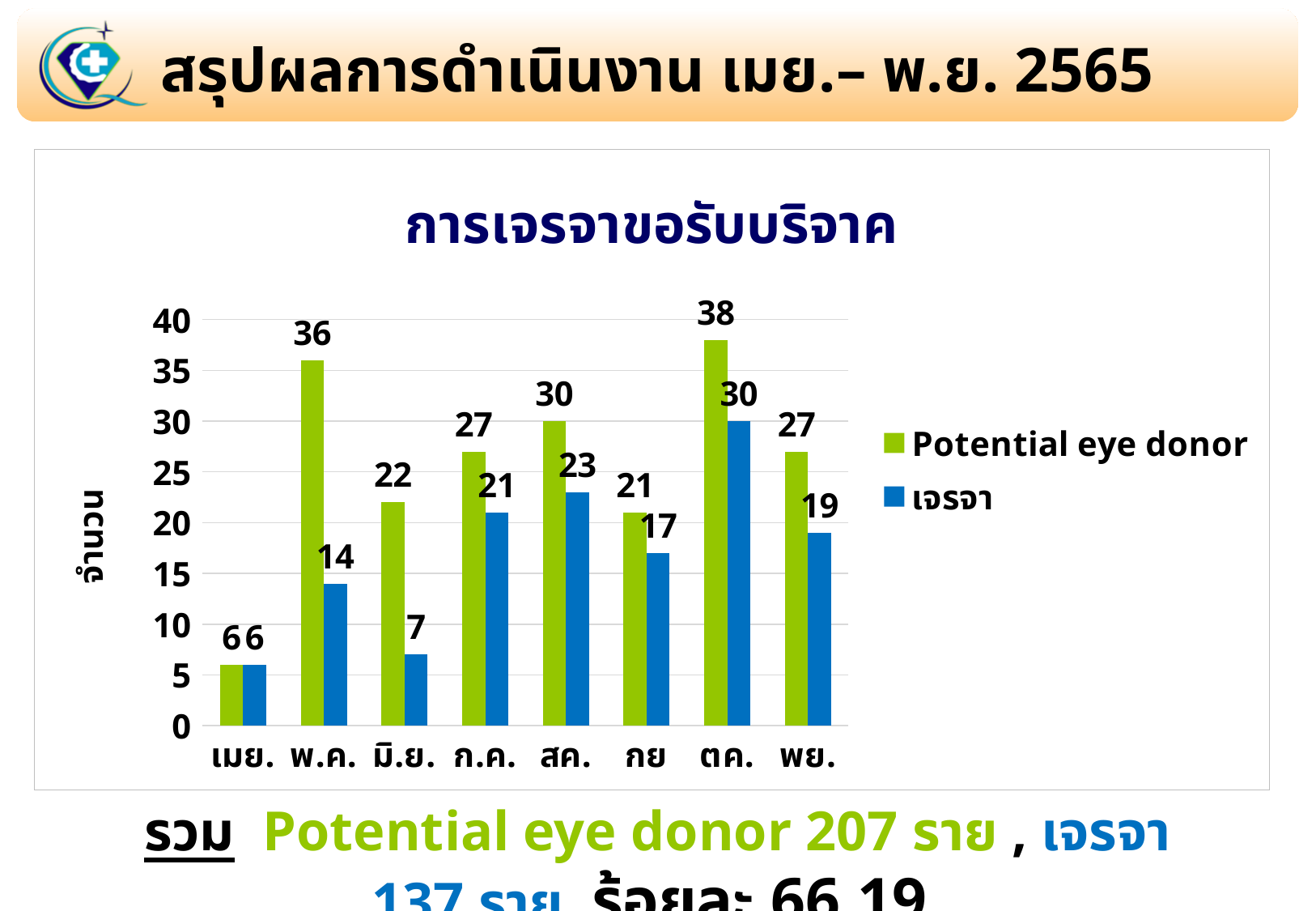
How many months are shown on the x axis? 8 What is the value for เจรจา in ก.ค.? 21 What is the value for Potential eye donor in ตค.? 38 Which is larger, the เจรจา value in สค. or the เจรจา value in กย? สค. What is the value for เจรจา in พ.ค.? 14 What is the difference between Potential eye donor and เจรจา in ตค.? 8 What kind of chart is shown? Bar chart Which month has the lowest value for เจรจา? เมย. What is the title of the chart? การเจรจาขอรับบริจาค What is the difference between Potential eye donor and เจรจา in พ.ค.? 22 Which month has the highest value for Potential eye donor? ตค. How many series does the legend list? 2